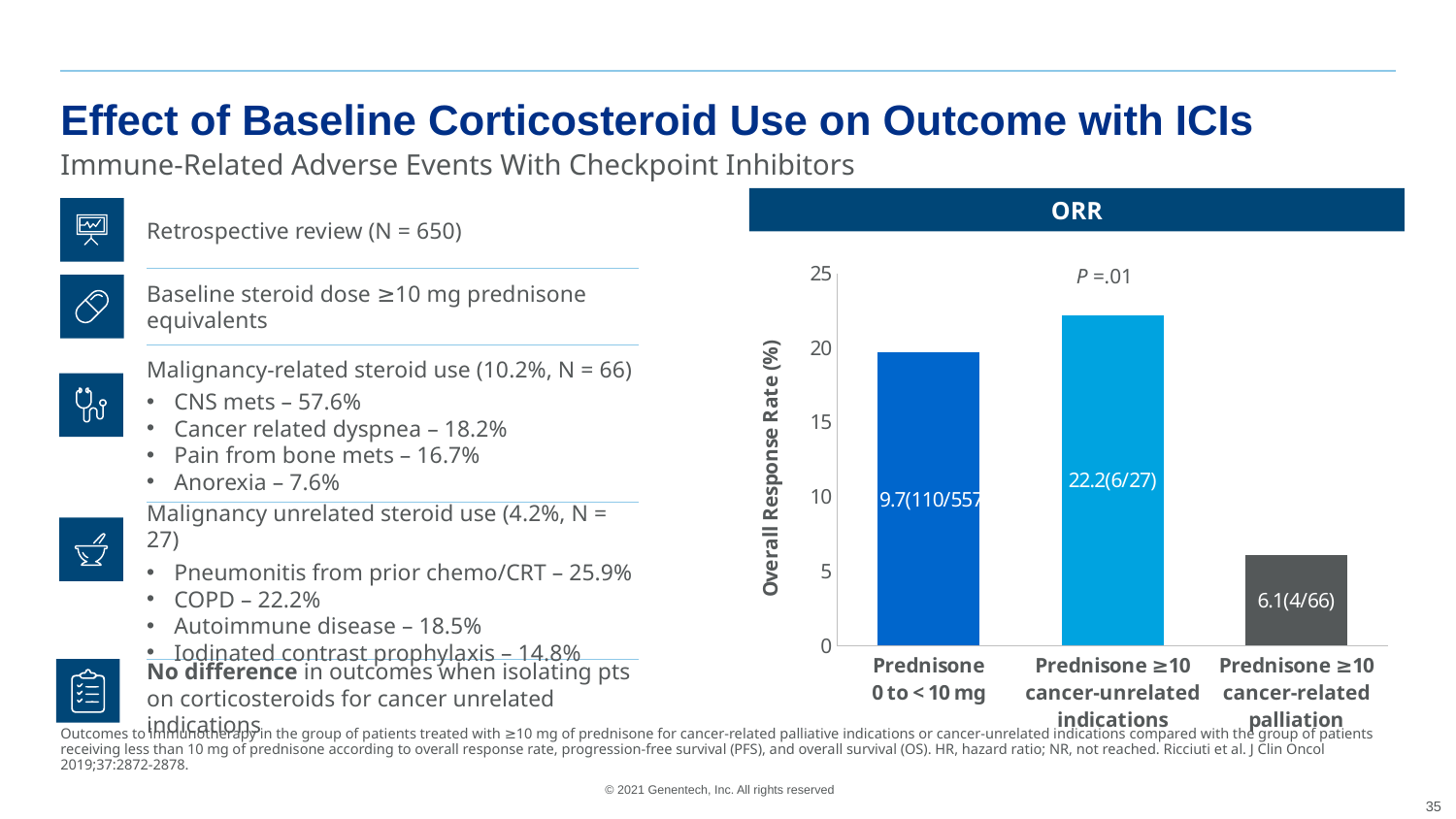
Is the overall response rate for the Prednisone ≥10 cancer-unrelated indications group greater or less than 20? greater Which group has the highest overall response rate in the ORR chart? Prednisone ≥10 cancer-unrelated indications What is the overall response rate shown for the Prednisone ≥10 cancer-unrelated indications group? 22.2(6/27) How many groups (bars) are shown in the ORR chart? 3 Which group has the lowest overall response rate in the ORR chart? Prednisone ≥10 cancer-related palliation What is the overall response rate shown for the Prednisone 0 to < 10 mg group? 9.7(110/557) Which has a higher overall response rate: the Prednisone 0 to < 10 mg group or the Prednisone ≥10 cancer-related palliation group? Prednisone 0 to < 10 mg What is the P value shown on the ORR chart? P = .01 What is the overall response rate shown for the Prednisone ≥10 cancer-related palliation group? 6.1(4/66) What type of chart is used to display the ORR data? Bar chart